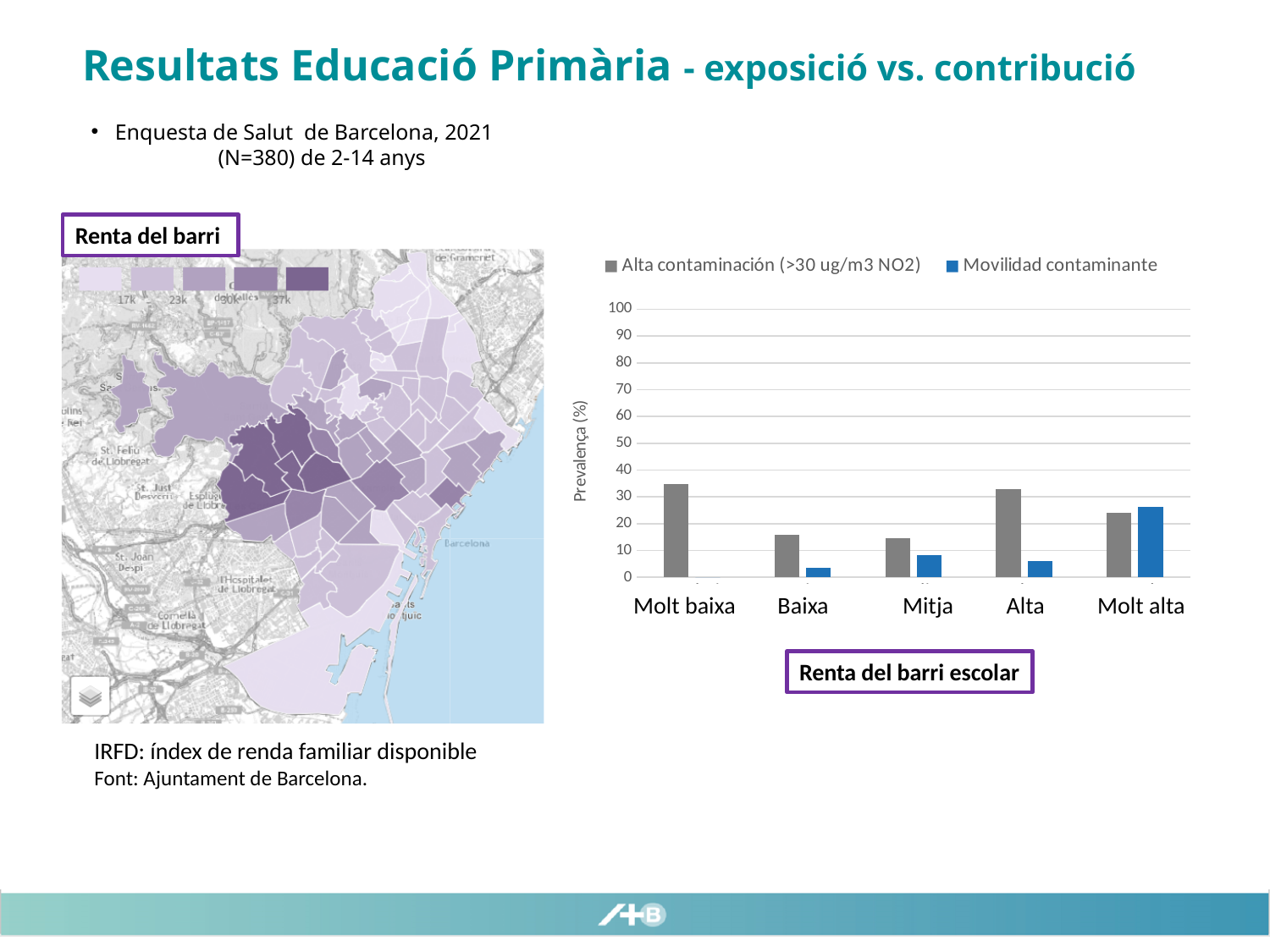
How many series does the legend of the bar chart list? 2 Is the value of 'Movilidad contaminante' for 'Baixa' greater or less than 10? less Which category has the highest value for 'Movilidad contaminante'? Molt alta Is the value of 'Movilidad contaminante' for 'Molt alta' greater or less than 20? greater Is the value of 'Movilidad contaminante' for 'Mitja' greater or less than 10? less How many categories are shown on the x axis of the bar chart? 5 What kind of chart is shown on the right of the slide? bar chart Which colour represents the 'Movilidad contaminante' series in the bar chart? blue What is the label of the y axis of the bar chart? Prevalença (%) For the 'Molt baixa' category, which series has the larger value: 'Alta contaminación (>30 ug/m3 NO2)' or 'Movilidad contaminante'? Alta contaminación (>30 ug/m3 NO2)